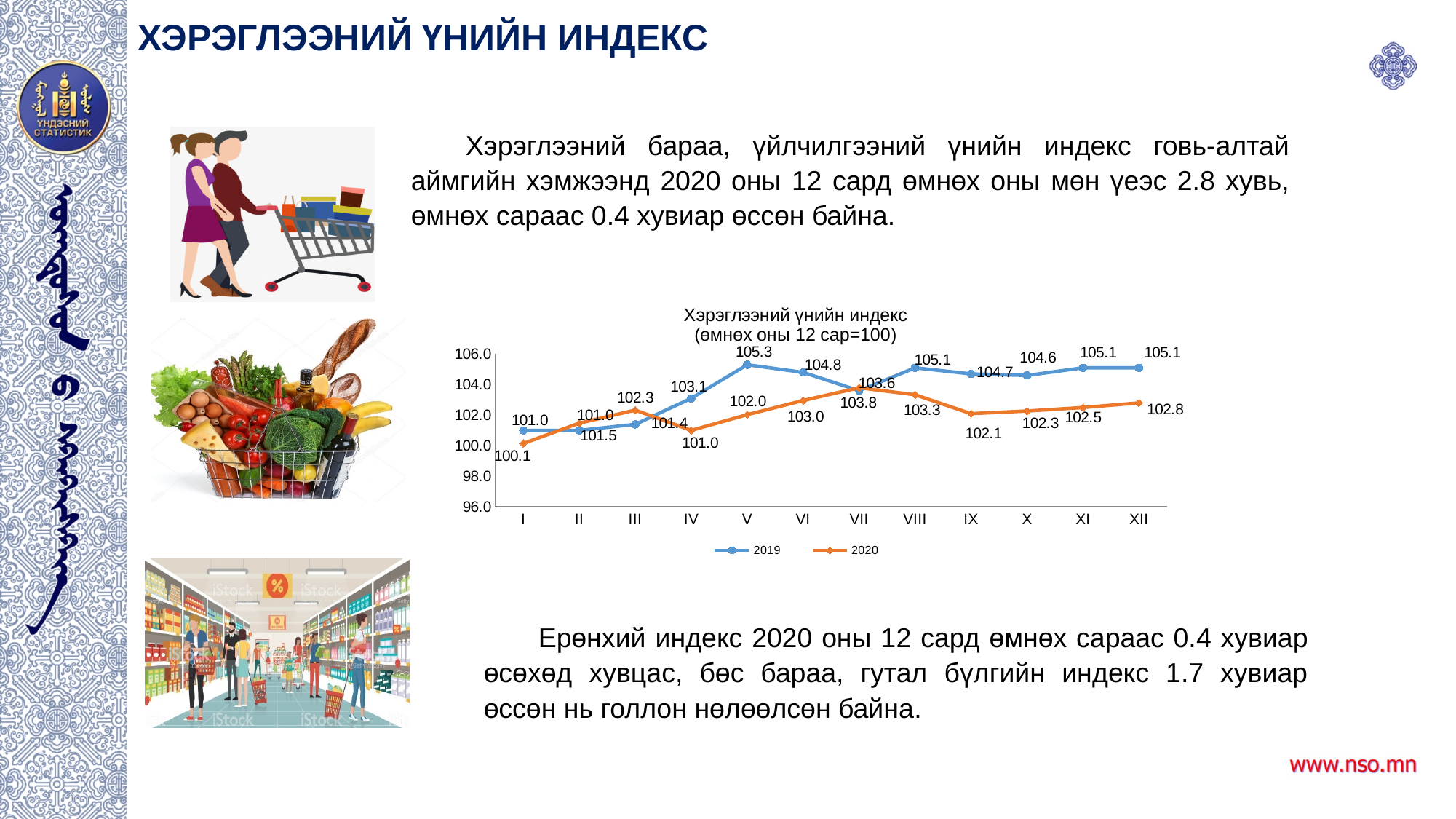
What are the two entries in the chart legend? 2019 and 2020 What is the 2020 value for month I? 100.1 What is the 2019 value for month V? 105.3 What type of chart is shown on the slide? line chart How many series does the chart legend list? 2 Is the 2020 value for month IX greater or less than 104.0? less Which series has the larger value in month IV, 2019 or 2020? 2019 How many months are plotted along the x axis of the chart? 12 In which month does the 2019 series reach its highest value? V What is the difference between the 2019 and 2020 values for month XII? 2.3 What is the 2020 value for month XII? 102.8 In which month does the 2020 series have its lowest value? I